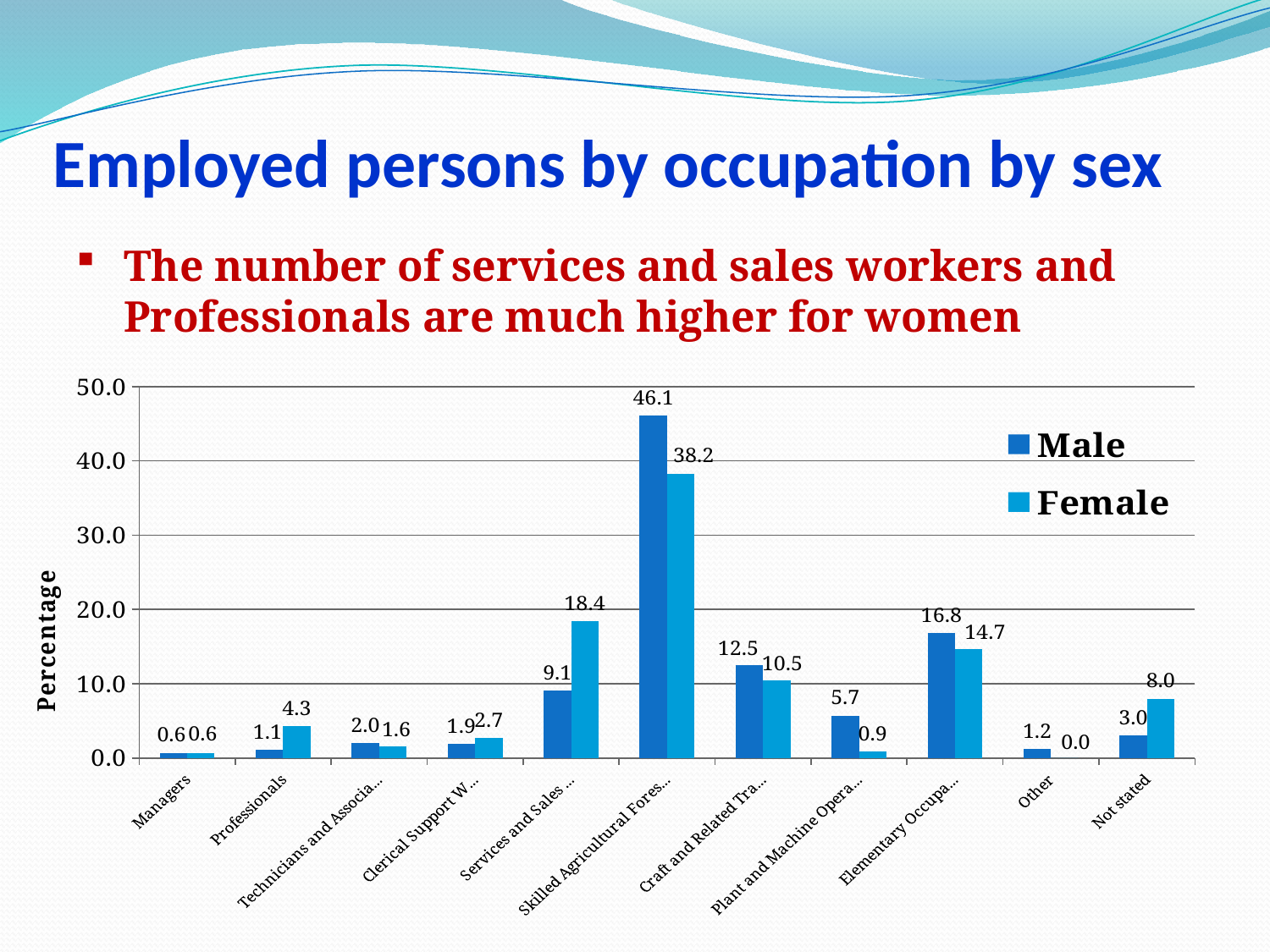
What is the difference between the Female and Male values for Not stated? 5.0 What is the Female value for Other? 0.0 What is the Female value for Professionals? 4.3 Which occupation category has the lowest Female value? Other What kind of chart is shown on the slide? Bar chart What is the Male value for Not stated? 3.0 How many series does the legend list? 2 What is the difference between the Male and Female values for Skilled Agricultural Fores...? 7.9 What is the Male value for Managers? 0.6 Which is larger for Professionals, the Male value or the Female value? Female Which occupation category has the highest Male value? Skilled Agricultural Fores... How many occupation categories are shown on the x axis? 11